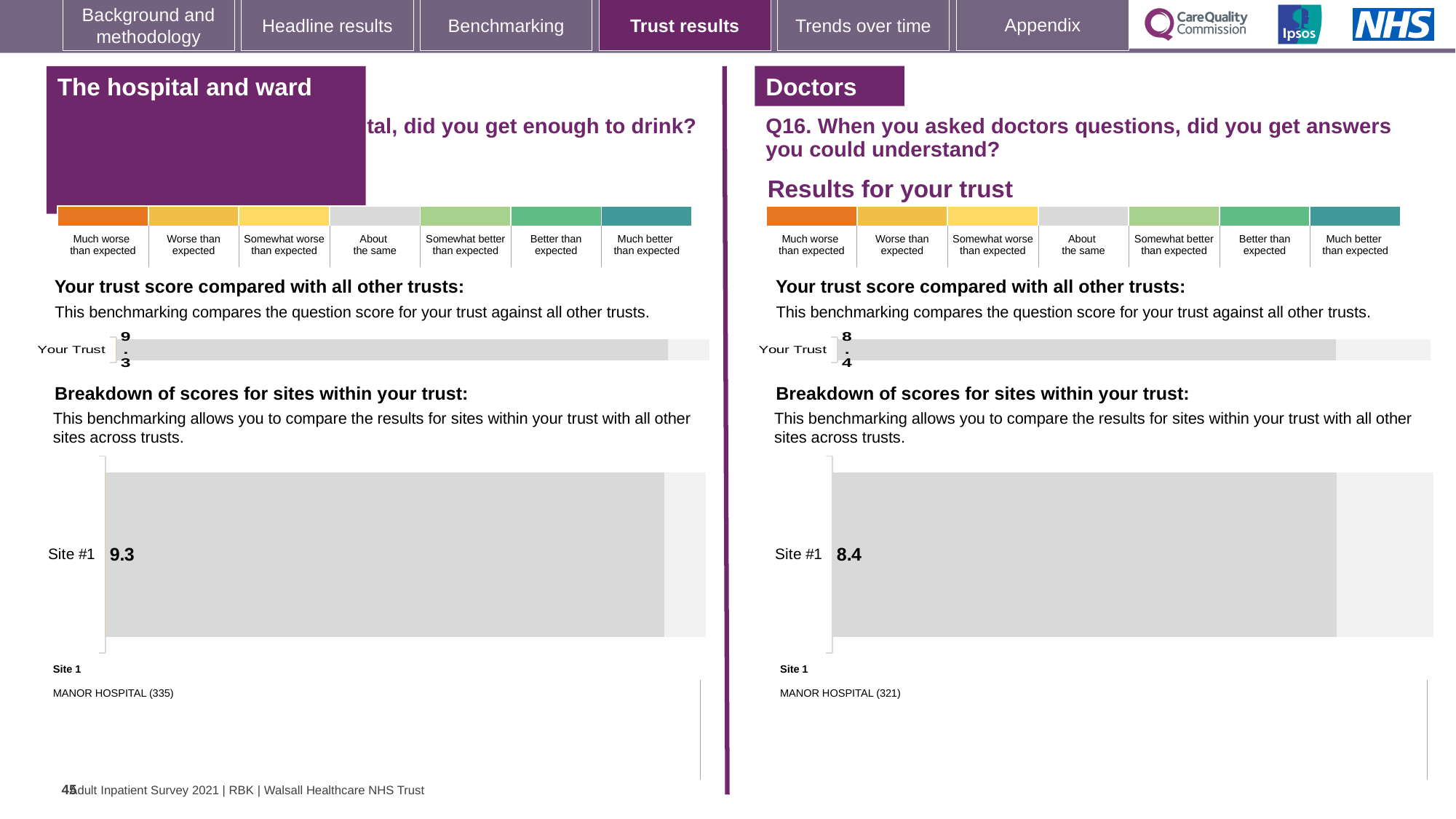
In the 'Breakdown of scores for sites within your trust' chart in the left (The hospital and ward) panel, what is the score for Site #1? 9.3 In the 'Your trust score compared with all other trusts' chart in the left (The hospital and ward) panel, what is the score shown for Your Trust? 9.3 How many sites are shown in the 'Breakdown of scores for sites within your trust' chart in the left (The hospital and ward) panel? 1 What is the difference between the Your Trust score in the hospital and ward panel (9.3) and the Your Trust score in the Doctors (Q16) panel (8.4)? 0.9 Is the Your Trust score in the Doctors (Q16) panel greater or less than the Your Trust score in the hospital and ward panel? less In the 'Your trust score compared with all other trusts' chart in the right (Doctors, Q16) panel, what is the score shown for Your Trust? 8.4 How many benchmarking categories are shown in the colour scale above the charts in each panel? 7 In the 'Breakdown of scores for sites within your trust' chart in the right (Doctors, Q16) panel, what is the score for Site #1? 8.4 In the Doctors (Q16) panel, which site is listed as Site 1 below the breakdown chart? MANOR HOSPITAL (321) How many sites are shown in the 'Breakdown of scores for sites within your trust' chart in the right (Doctors, Q16) panel? 1 What kind of chart is used to show the Site #1 score in the Doctors (Q16) panel? bar chart